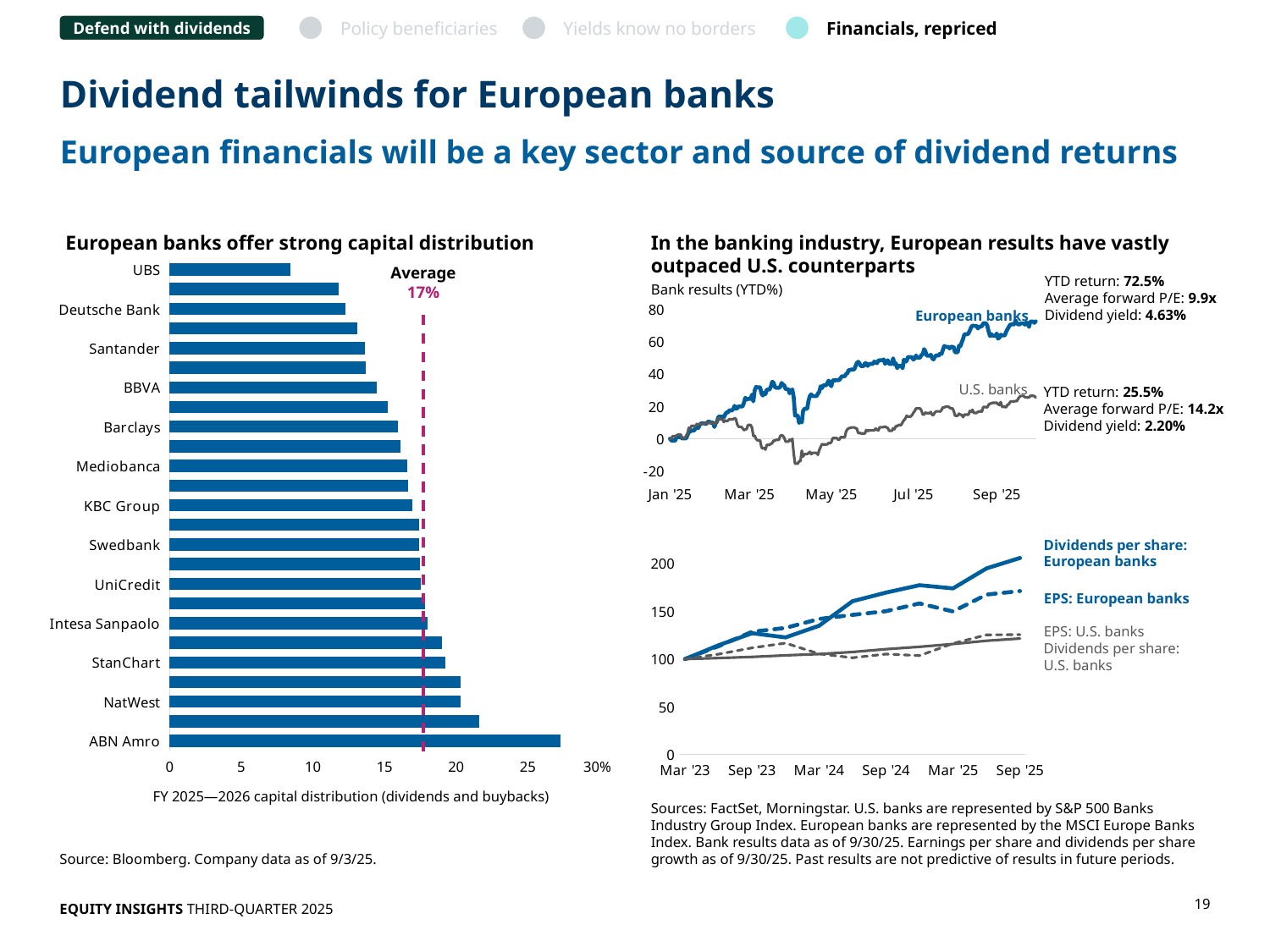
In the bottom-right chart showing dividends per share and EPS, how many series are listed in the legend? 4 In the 'European banks offer strong capital distribution' chart, what is the average capital distribution marked on the chart? 17% In the 'European banks offer strong capital distribution' chart, is the value for ABN Amro greater or less than 25? greater In the 'European banks offer strong capital distribution' chart, which labeled bank has the highest capital distribution? ABN Amro In the 'In the banking industry, European results have vastly outpaced U.S. counterparts' chart, what is the difference between the YTD return of European banks and U.S. banks? 47.0 percentage points In the 'In the banking industry, European results have vastly outpaced U.S. counterparts' chart, what is the YTD return for European banks? 72.5% In the 'European banks offer strong capital distribution' chart, which labeled bank has the lowest capital distribution? UBS What type of chart is 'European banks offer strong capital distribution'? Bar chart In the 'In the banking industry, European results have vastly outpaced U.S. counterparts' chart, how many series are plotted? 2 In the 'In the banking industry, European results have vastly outpaced U.S. counterparts' chart, what is the dividend yield for U.S. banks? 2.20% In the 'European banks offer strong capital distribution' chart, is the value for UBS greater or less than 10? less In the 'European banks offer strong capital distribution' chart, which is larger, the value for NatWest or the value for Deutsche Bank? NatWest